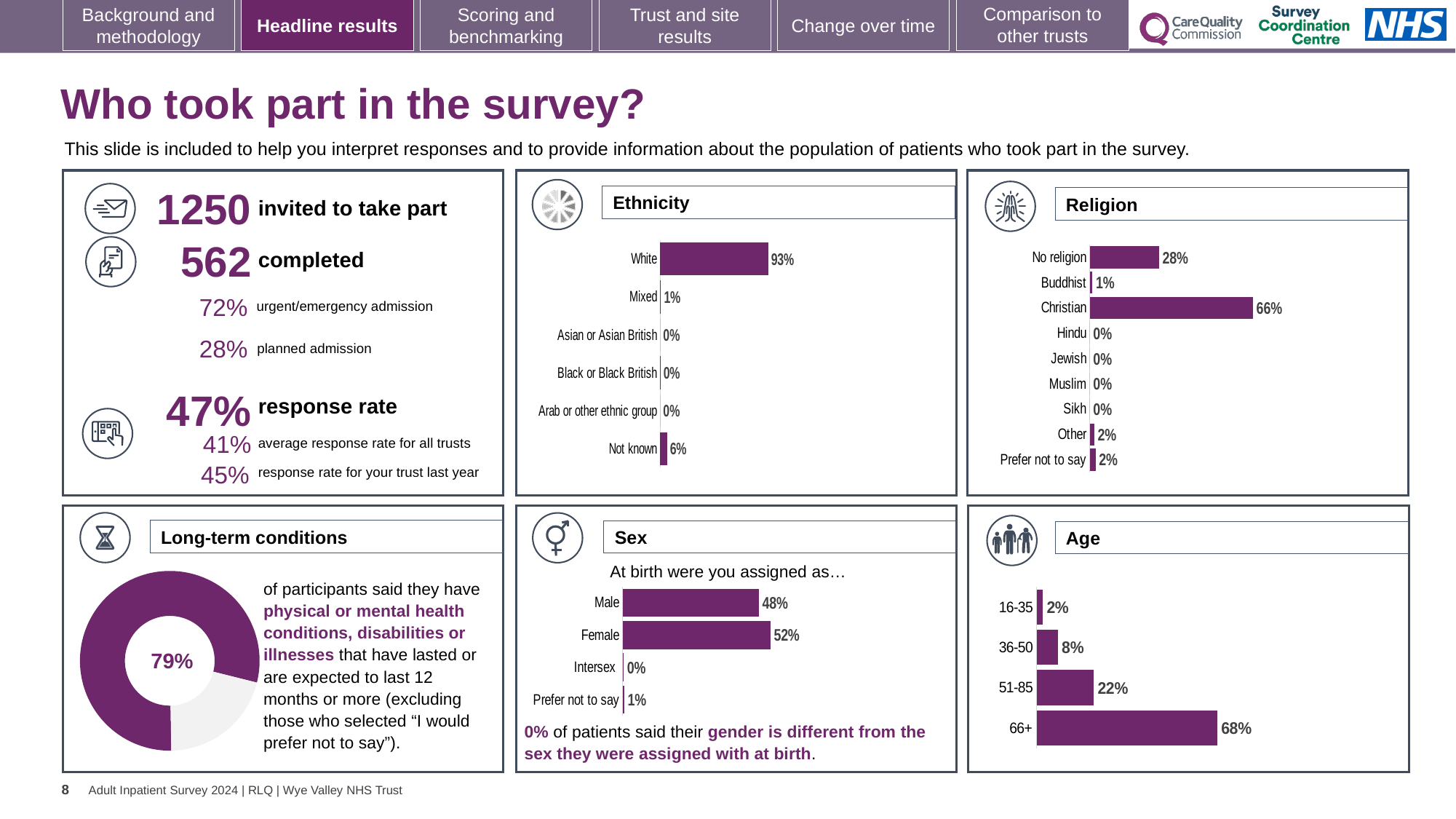
What kind of chart is used in the Long-term conditions panel? doughnut chart In the Ethnicity chart, what percentage of respondents are White? 93% In the Ethnicity chart, what is the difference between the White and Not known values? 87% In the Ethnicity chart, which category has the highest value? White In the Age chart, what percentage of respondents are aged 66+? 68% In the Religion chart, what is the difference between the Christian and No religion values? 38% In the Religion chart, what percentage of respondents are Christian? 66% In the Long-term conditions chart, what share of participants said they have long-term conditions? 79% In the Religion chart, how many categories are shown? 9 In the Age chart, do the values rise or fall as age increases from 16-35 to 66+? rise In the Sex chart, what percentage of respondents answered Prefer not to say? 1% In the Sex chart, which is larger, Male or Female? Female